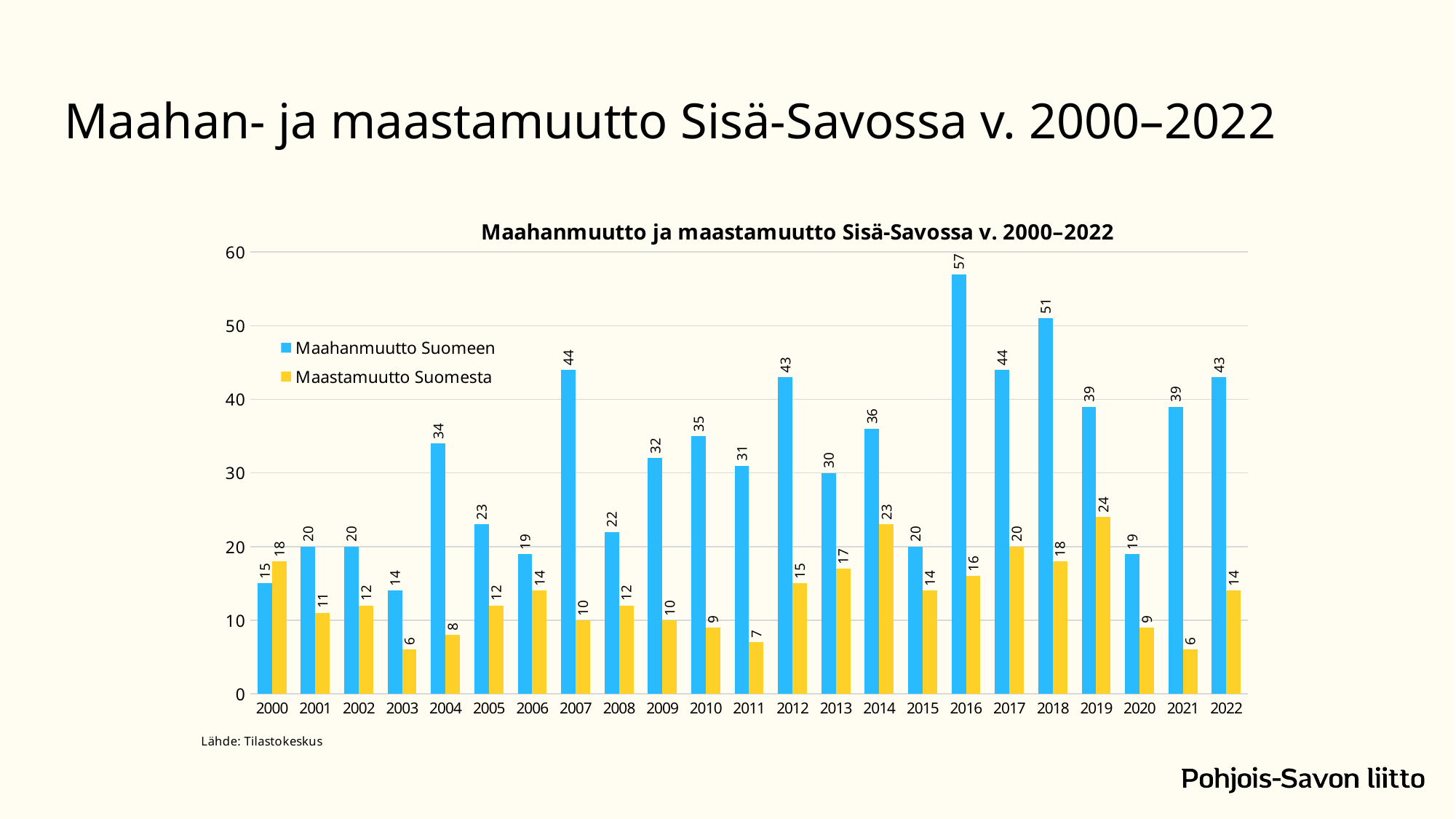
Which year has the lowest value for Maahanmuutto Suomeen? 2003 How many series does the legend list? 2 Is the value for Maahanmuutto Suomeen in 2007 greater or less than 40? greater What kind of chart is shown on the slide? Bar chart How many years are shown on the x axis? 23 Which is larger in 2000, Maahanmuutto Suomeen or Maastamuutto Suomesta? Maastamuutto Suomesta What is the difference between Maahanmuutto Suomeen and Maastamuutto Suomesta in 2018? 33 What is the title of the chart? Maahanmuutto ja maastamuutto Sisä-Savossa v. 2000–2022 What is the value of Maastamuutto Suomesta in 2019? 24 Which year has the highest value for Maahanmuutto Suomeen? 2016 Which year has the highest value for Maastamuutto Suomesta? 2019 What is the value of Maahanmuutto Suomeen in 2016? 57